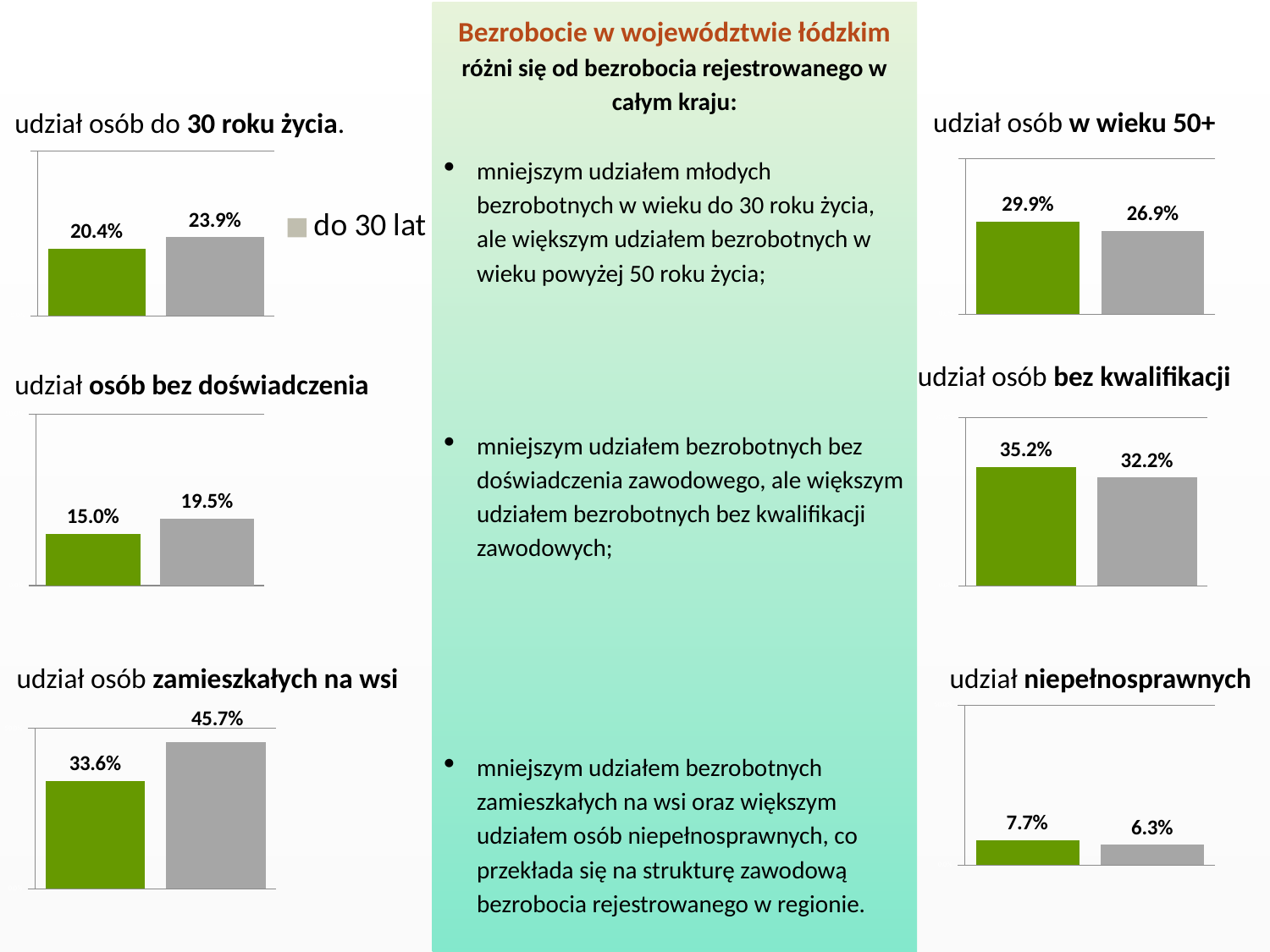
In the chart titled 'udział osób zamieszkałych na wsi', which bar is higher, the green one or the grey one? the grey one In the chart titled 'udział osób bez kwalifikacji', what is the difference between the green bar and the grey bar? 3.0% In the chart titled 'udział niepełnosprawnych', what value is shown on the grey (right) bar? 6.3% In the chart titled 'udział niepełnosprawnych', which bar is higher, the green one or the grey one? the green one What legend entry is shown next to the chart titled 'udział osób do 30 roku życia'? do 30 lat In the chart titled 'udział osób zamieszkałych na wsi', what is the difference between the grey bar and the green bar? 12.1% In the chart titled 'udział osób bez doświadczenia', what value is shown on the grey (right) bar? 19.5% How many bars does the chart titled 'udział osób bez doświadczenia' contain? 2 In the chart titled 'udział osób w wieku 50+', what value is shown on the green (left) bar? 29.9% In the chart titled 'udział osób do 30 roku życia', what value is shown on the green (left) bar? 20.4% What type of chart is used for 'udział osób w wieku 50+'? bar chart In the chart titled 'udział osób do 30 roku życia', what value is shown on the grey (right) bar? 23.9%